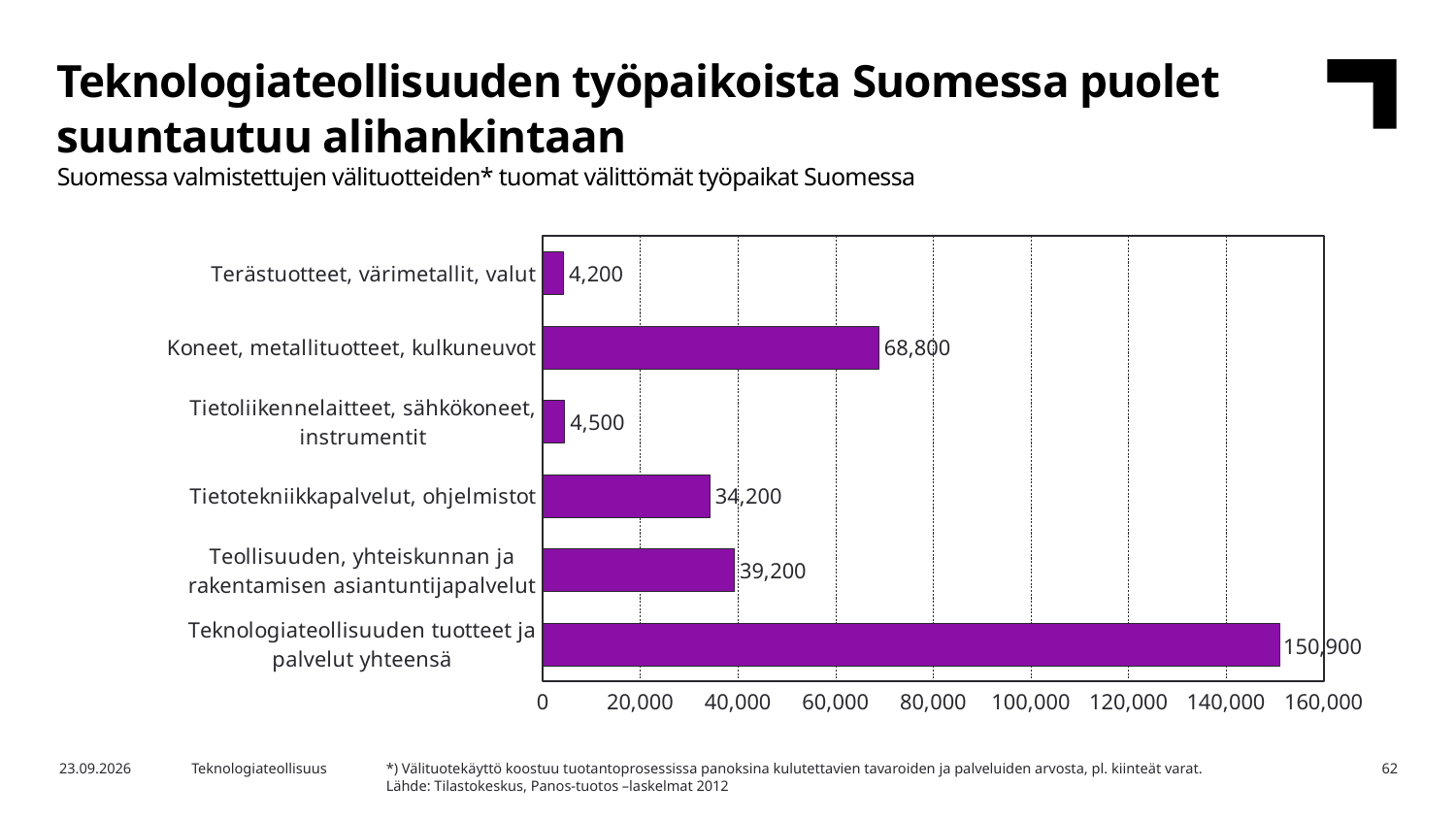
What is the value for Terästuotteet, värimetallit, valut? 4,200 What kind of chart is shown on the slide? bar chart Which category has the highest value? Teknologiateollisuuden tuotteet ja palvelut yhteensä Is the value for Koneet, metallituotteet, kulkuneuvot greater or less than 60,000? greater Which is larger: Tietoliikennelaitteet, sähkökoneet, instrumentit or Terästuotteet, värimetallit, valut? Tietoliikennelaitteet, sähkökoneet, instrumentit What is the value for Tietotekniikkapalvelut, ohjelmistot? 34,200 What is the difference between Teollisuuden, yhteiskunnan ja rakentamisen asiantuntijapalvelut and Tietotekniikkapalvelut, ohjelmistot? 5,000 What is the difference between Koneet, metallituotteet, kulkuneuvot and Tietotekniikkapalvelut, ohjelmistot? 34,600 What is the value for Koneet, metallituotteet, kulkuneuvot? 68,800 What is the value for Teknologiateollisuuden tuotteet ja palvelut yhteensä? 150,900 How many categories are shown in the chart? 6 Which category has the lowest value? Terästuotteet, värimetallit, valut